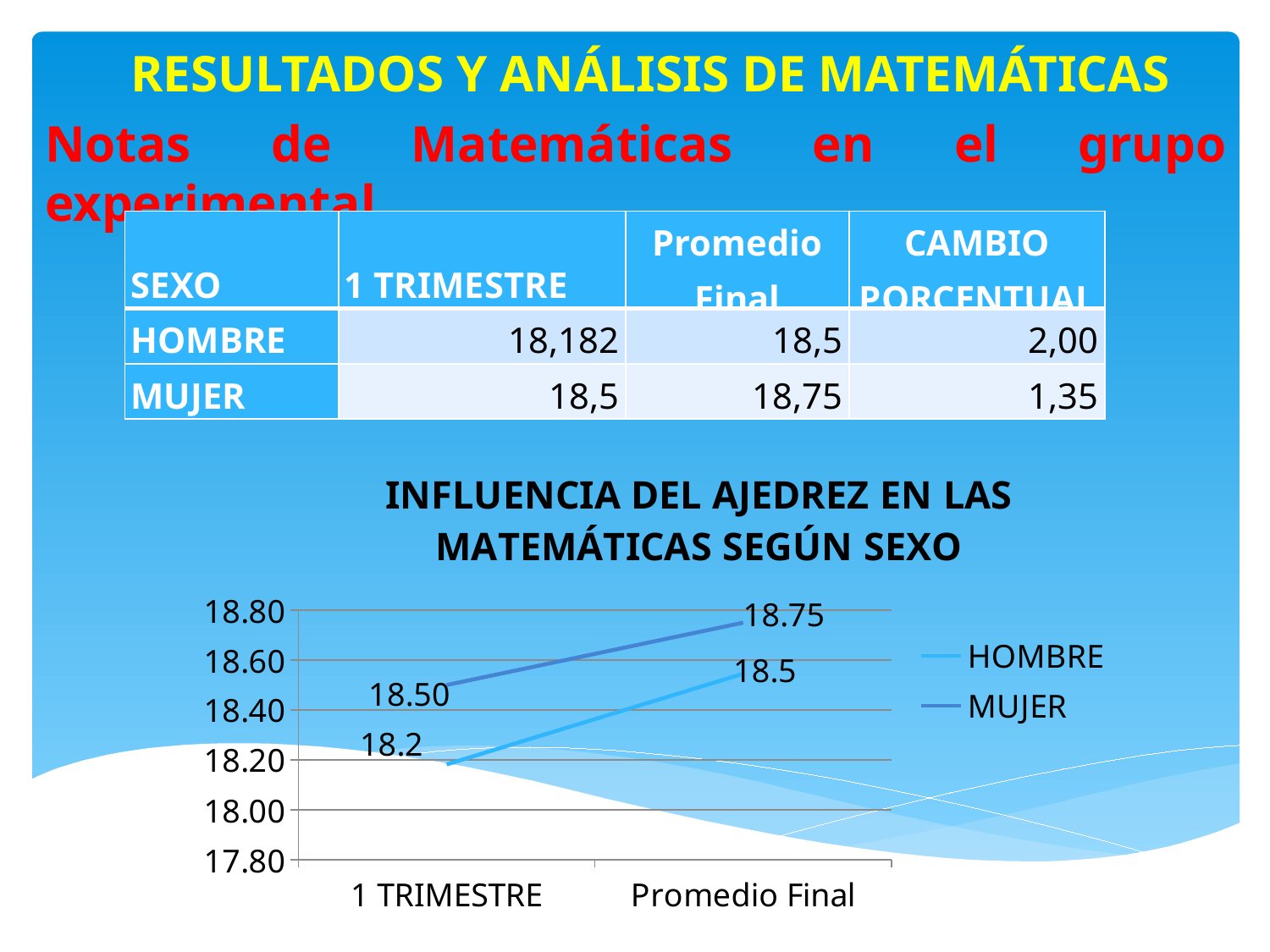
How many categories are shown on the x axis of the chart? 2 What is the value for MUJER at 1 TRIMESTRE in the chart? 18.50 What is the value for HOMBRE at 1 TRIMESTRE in the chart? 18.2 Does the HOMBRE line rise or fall from 1 TRIMESTRE to Promedio Final? rise What type of chart is shown under the title "INFLUENCIA DEL AJEDREZ EN LAS MATEMÁTICAS SEGÚN SEXO"? line chart Which series has the higher value at Promedio Final, HOMBRE or MUJER? MUJER Which series is shown in the darker blue line in the chart? MUJER What is the value for HOMBRE at Promedio Final in the chart? 18.5 How many series does the chart legend list? 2 Is the value for HOMBRE at 1 TRIMESTRE greater or less than 18.40? less What is the difference between the MUJER value and the HOMBRE value at Promedio Final? 0.25 What is the value for MUJER at Promedio Final in the chart? 18.75